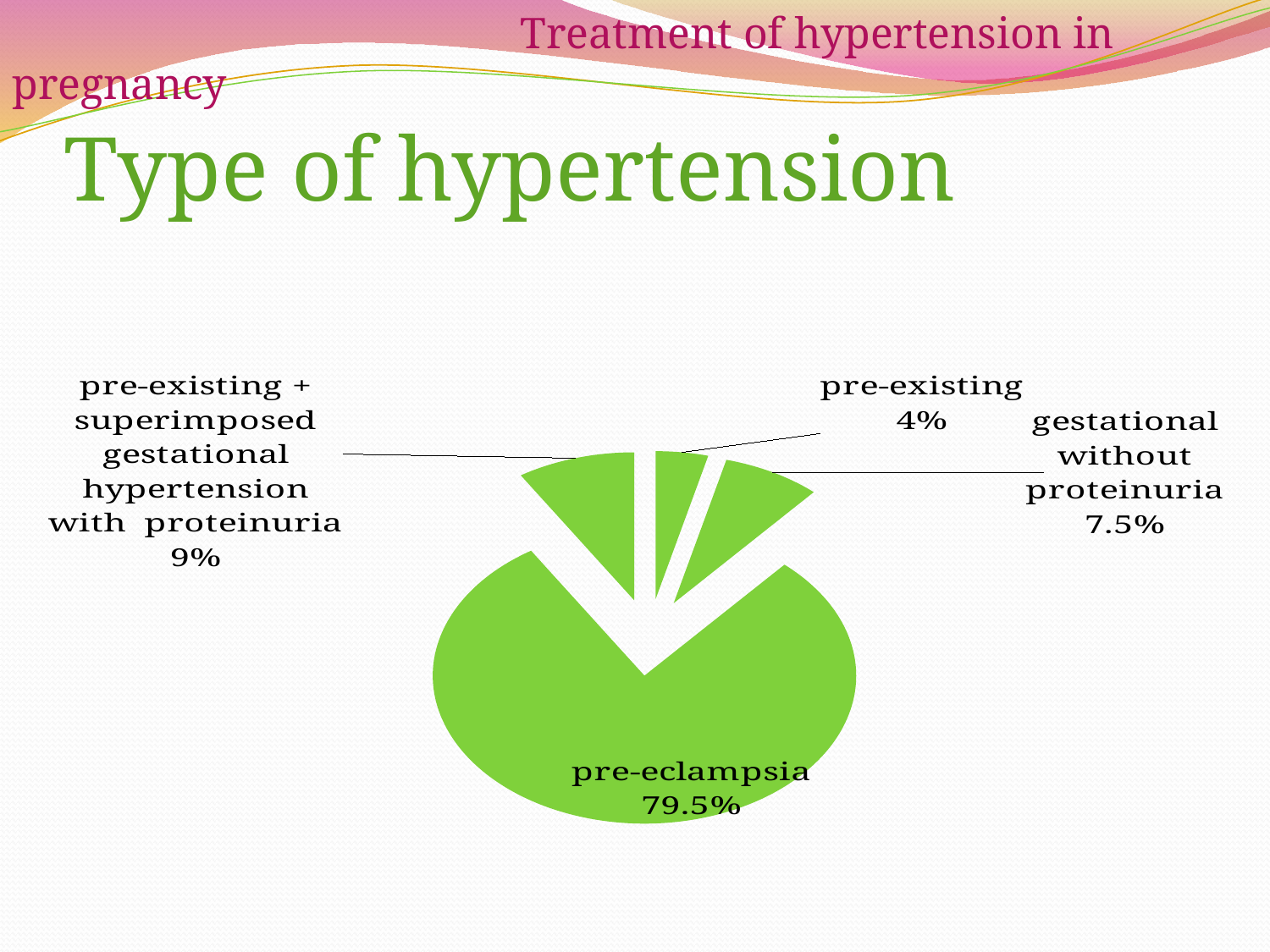
What is the value shown for gestational without proteinuria? 7.5% What share of the pie does pre-eclampsia account for? 79.5% What is the value shown for pre-existing + superimposed gestational hypertension with proteinuria? 9% What is the title of the slide containing the pie chart? Type of hypertension Which type of hypertension has the largest slice of the pie? pre-eclampsia Which type of hypertension has the smallest slice of the pie? pre-existing How many slices does the pie chart have? 4 What is the value shown for pre-existing hypertension? 4% What is the difference between the pre-eclampsia share and the gestational without proteinuria share? 72% What is the difference between the 9% slice and the 4% slice? 5% Which is larger: the share for gestational without proteinuria or the share for pre-existing? gestational without proteinuria What kind of chart is shown on the slide? pie chart